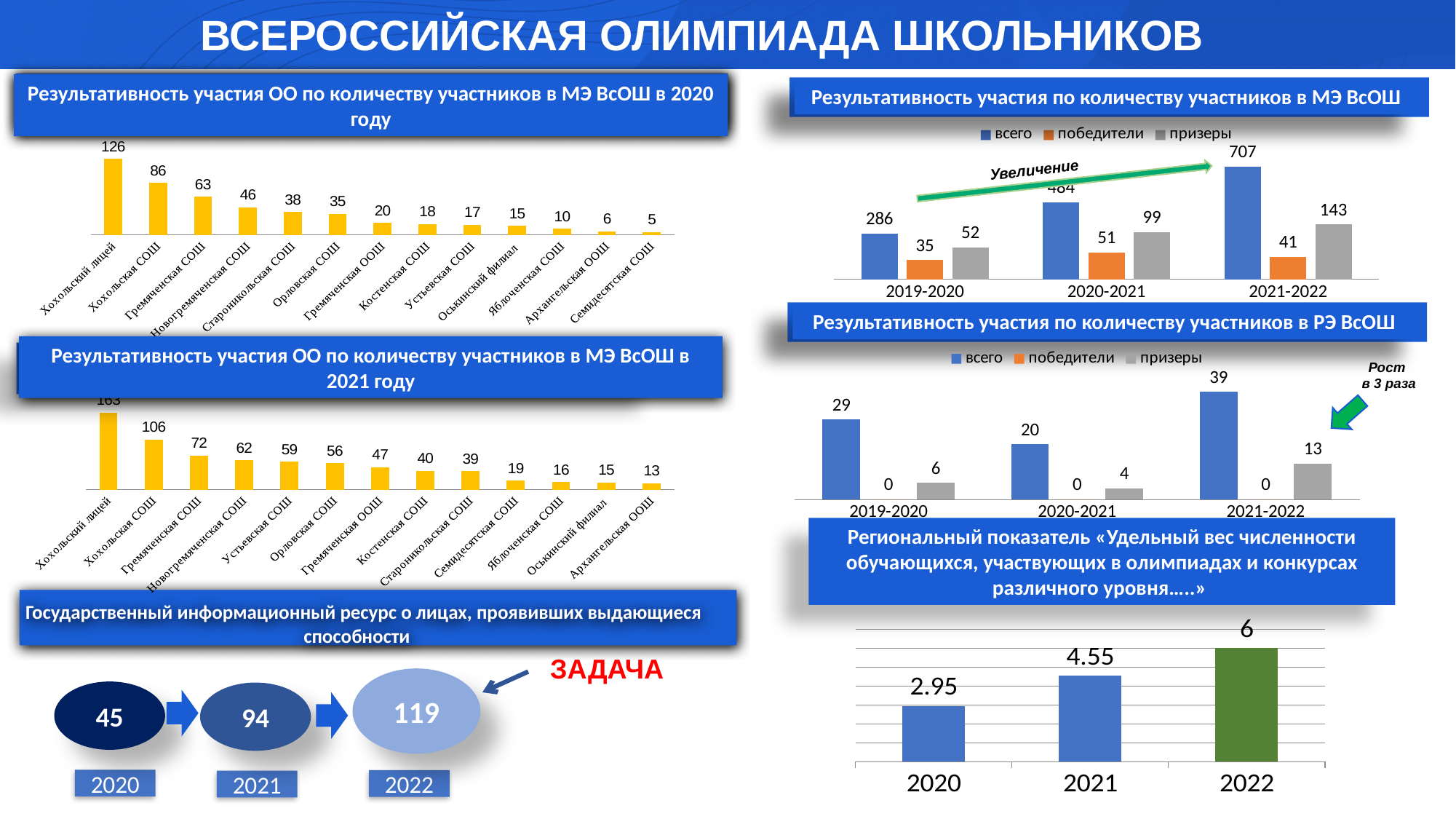
In the chart 'Результативность участия по количеству участников в МЭ ВсОШ', what is the value of 'всего' for 2021-2022? 707 In the chart 'Результативность участия ОО по количеству участников в МЭ ВсОШ в 2020 году', how many categories are shown? 13 In the chart 'Результативность участия ОО по количеству участников в МЭ ВсОШ в 2021 году', what is the difference between Хохольская СОШ and Гремяченская СОШ? 34 In the chart 'Результативность участия ОО по количеству участников в МЭ ВсОШ в 2021 году', what is the value for Орловская СОШ? 56 In the chart 'Результативность участия ОО по количеству участников в МЭ ВсОШ в 2020 году', what is the value for Хохольская СОШ? 86 In the chart 'Результативность участия по количеству участников в МЭ ВсОШ', which is larger for 2021-2022: 'победители' or 'призеры'? призеры In the chart 'Результативность участия ОО по количеству участников в МЭ ВсОШ в 2020 году', which category has the lowest value? Семидесятская СОШ In the chart 'Результативность участия по количеству участников в РЭ ВсОШ', what is the value of 'победители' for 2020-2021? 0 In the chart 'Региональный показатель «Удельный вес численности обучающихся, участвующих в олимпиадах и конкурсах различного уровня…»', do the values rise or fall from 2020 to 2022? rise In the chart 'Результативность участия по количеству участников в МЭ ВсОШ', how many series does the legend list? 3 In the chart 'Результативность участия по количеству участников в РЭ ВсОШ', what is the value of 'призеры' for 2021-2022? 13 What kind of chart is 'Региональный показатель «Удельный вес численности обучающихся, участвующих в олимпиадах и конкурсах различного уровня…»'? bar chart